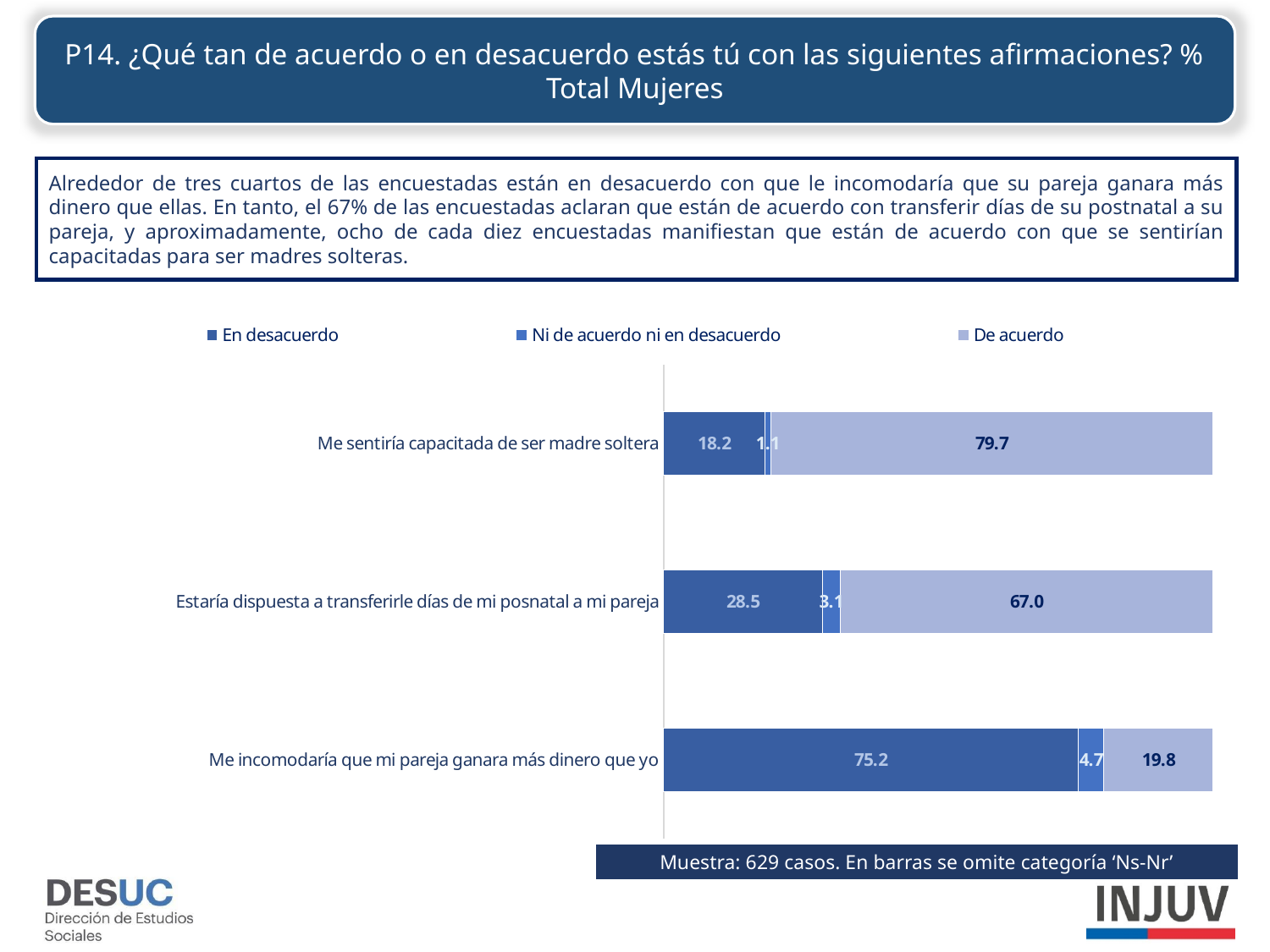
Which is larger: the 'En desacuerdo' value for 'Estaría dispuesta a transferirle días de mi posnatal a mi pareja' or for 'Me sentiría capacitada de ser madre soltera'? Estaría dispuesta a transferirle días de mi posnatal a mi pareja Which statement has the lowest 'En desacuerdo' value? Me sentiría capacitada de ser madre soltera What kind of chart is shown on the slide? Stacked bar chart What is the 'En desacuerdo' value for 'Me incomodaría que mi pareja ganara más dinero que yo'? 75.2 What is the total of the stacked bar for 'Me incomodaría que mi pareja ganara más dinero que yo'? 99.7 What is the difference between the 'De acuerdo' values for 'Me sentiría capacitada de ser madre soltera' and 'Estaría dispuesta a transferirle días de mi posnatal a mi pareja'? 12.7 What is the 'De acuerdo' value for 'Me sentiría capacitada de ser madre soltera'? 79.7 What is the sample size stated at the bottom of the slide? 629 casos How many statements (categories) are shown in the chart? 3 How many series does the legend list? 3 Which statement has the highest 'De acuerdo' value? Me sentiría capacitada de ser madre soltera What is the 'Ni de acuerdo ni en desacuerdo' value for 'Estaría dispuesta a transferirle días de mi posnatal a mi pareja'? 3.1